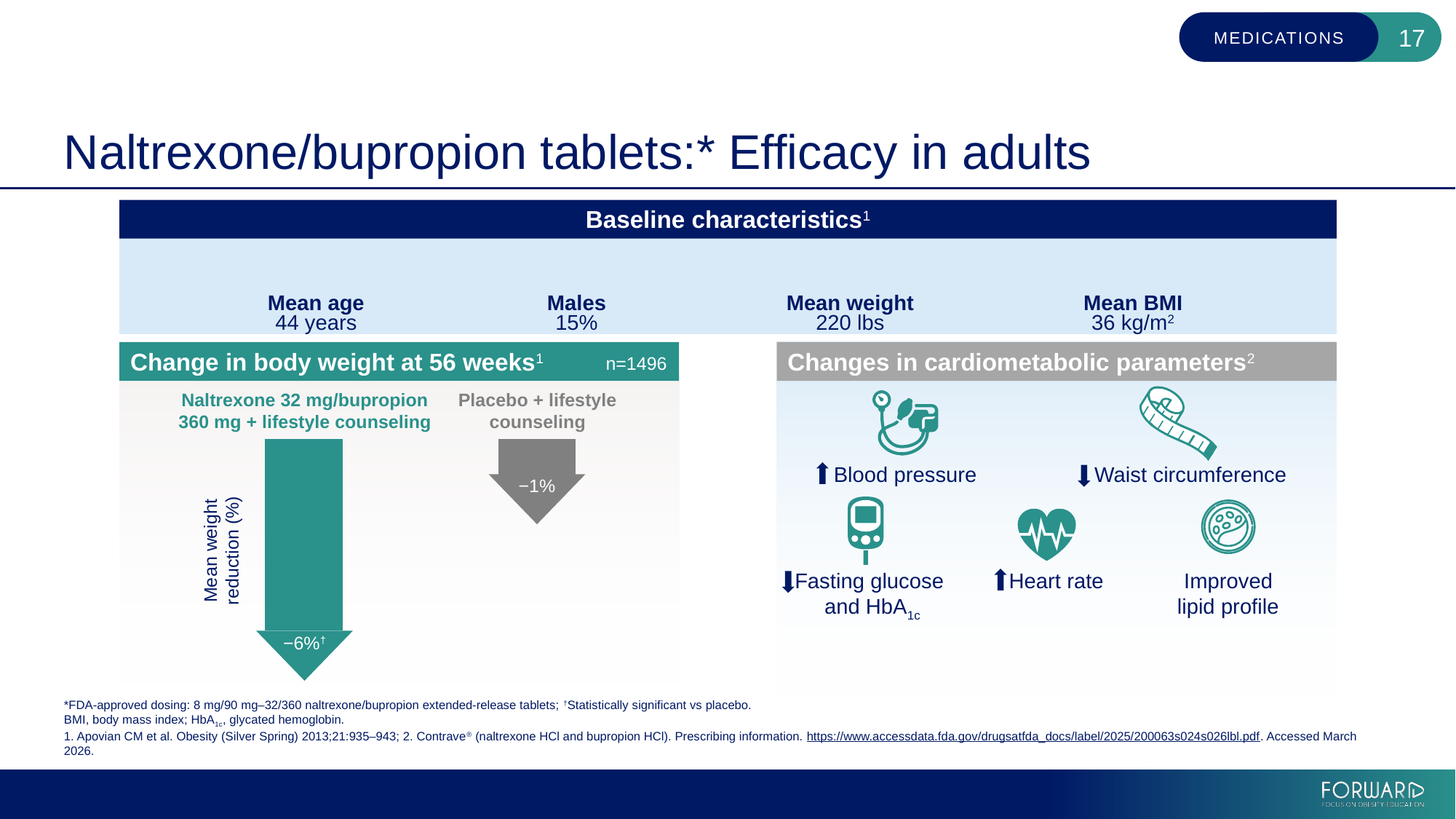
In the 'Change in body weight at 56 weeks' chart, which group shows the smaller mean weight reduction? Placebo + lifestyle counseling In the 'Change in body weight at 56 weeks' chart, which group shows the larger mean weight reduction? Naltrexone 32 mg/bupropion 360 mg + lifestyle counseling In the 'Change in body weight at 56 weeks' chart, which group's result is marked as statistically significant vs placebo? Naltrexone 32 mg/bupropion 360 mg + lifestyle counseling In the 'Change in body weight at 56 weeks' chart, is the weight reduction larger for the naltrexone/bupropion group or the placebo group? Naltrexone/bupropion group What is the label on the vertical axis of the 'Change in body weight at 56 weeks' chart? Mean weight reduction (%) In the 'Change in body weight at 56 weeks' chart, what is the mean weight reduction for placebo + lifestyle counseling? −1% How many treatment groups are shown in the 'Change in body weight at 56 weeks' chart? 2 In the 'Change in body weight at 56 weeks' chart, what is the mean weight reduction for naltrexone 32 mg/bupropion 360 mg + lifestyle counseling? −6% What is the sample size (n) shown for the 'Change in body weight at 56 weeks' chart? n=1496 In the 'Change in body weight at 56 weeks' chart, what is the difference in mean weight reduction between the naltrexone/bupropion group and the placebo group? 5 percentage points